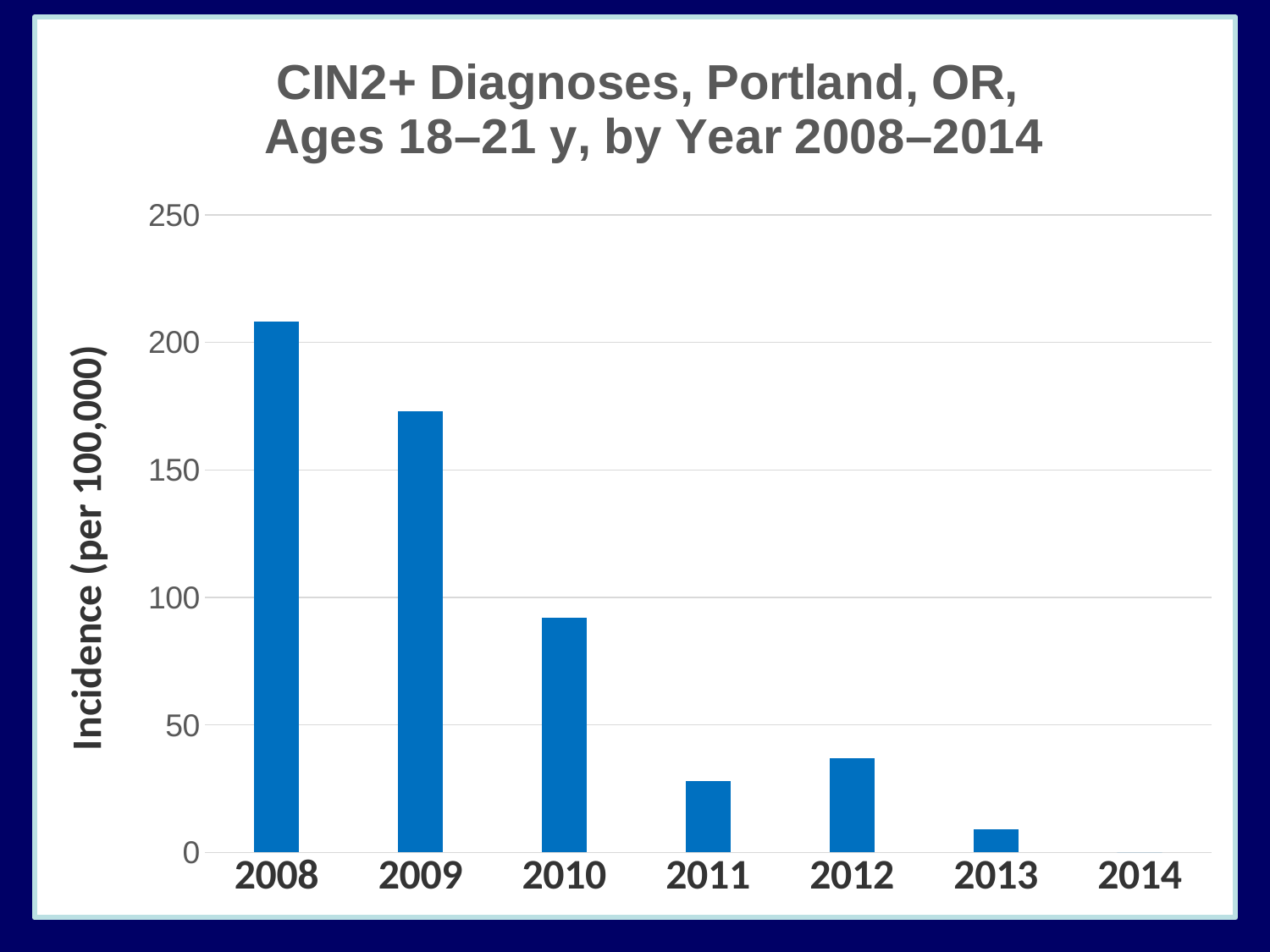
Which year has the highest incidence? 2008 What kind of chart is shown on the slide? Bar chart Do the values generally rise or fall from 2008 to 2013? Fall What is the label on the y axis? Incidence (per 100,000) Which year has the larger value, 2011 or 2012? 2012 Is the value for 2010 greater or less than 100? less How many years are listed along the x axis? 7 Is the value for 2011 greater or less than 50? less Is the value for 2008 greater or less than 200? greater Which year has the larger value, 2009 or 2010? 2009 Among the years with a visible bar, which has the lowest incidence? 2013